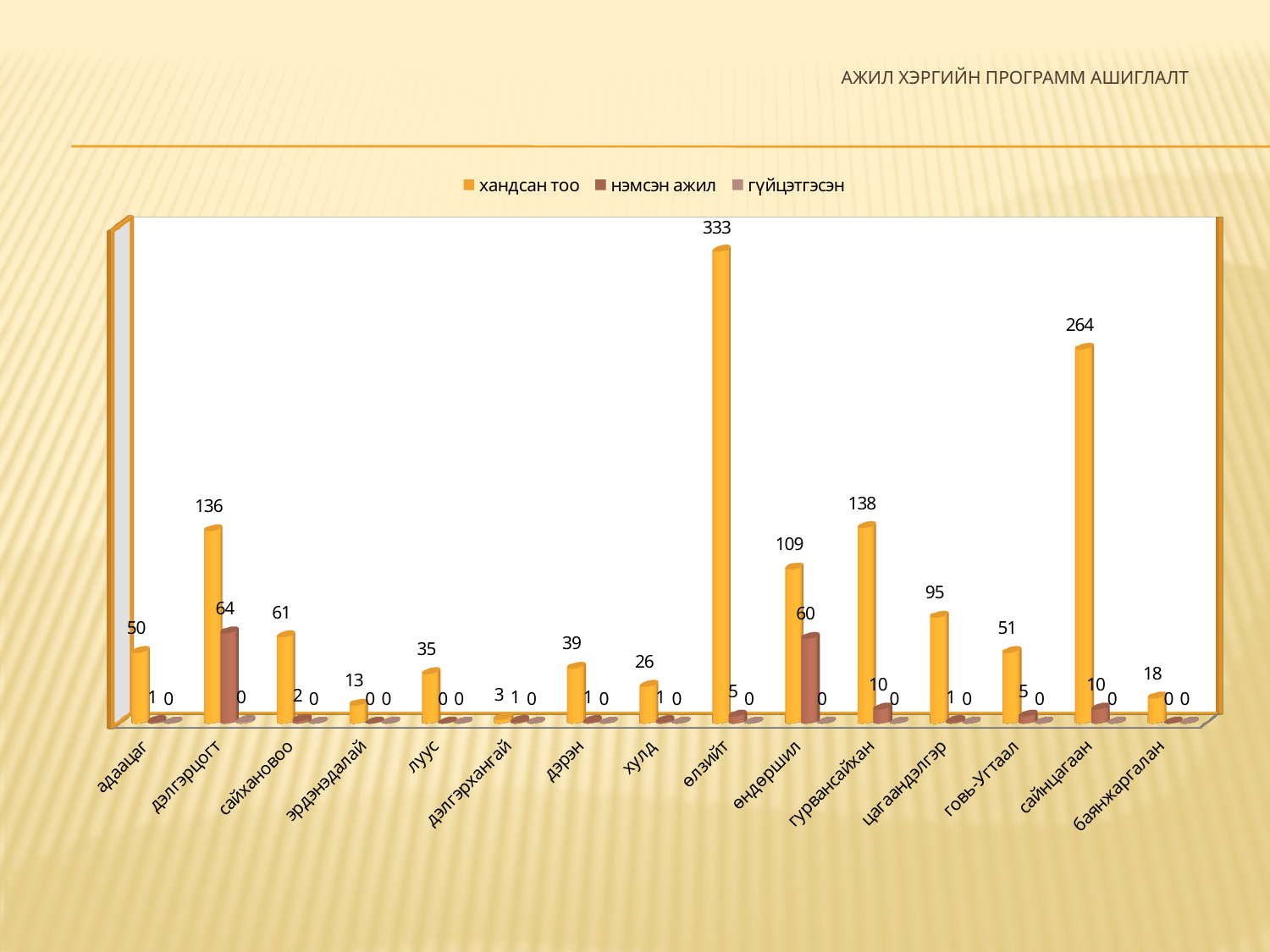
What kind of chart is shown on the slide? bar chart Which category has the highest хандсан тоо value? өлзийт What is the difference between the хандсан тоо values for өлзийт and сайнцагаан? 69 What is the value of хандсан тоо for сайнцагаан? 264 How many categories are shown on the x axis? 15 What is the title of the slide? АЖИЛ ХЭРГИЙН ПРОГРАММ АШИГЛАЛТ Which category has the lowest хандсан тоо value? дэлгэрхангай How many series does the legend list? 3 What is the value of хандсан тоо for өлзийт? 333 What is the value of нэмсэн ажил for дэлгэрцогт? 64 What is the value of нэмсэн ажил for өндөршил? 60 Which is larger, the хандсан тоо value for гурвансайхан or for дэлгэрцогт? гурвансайхан